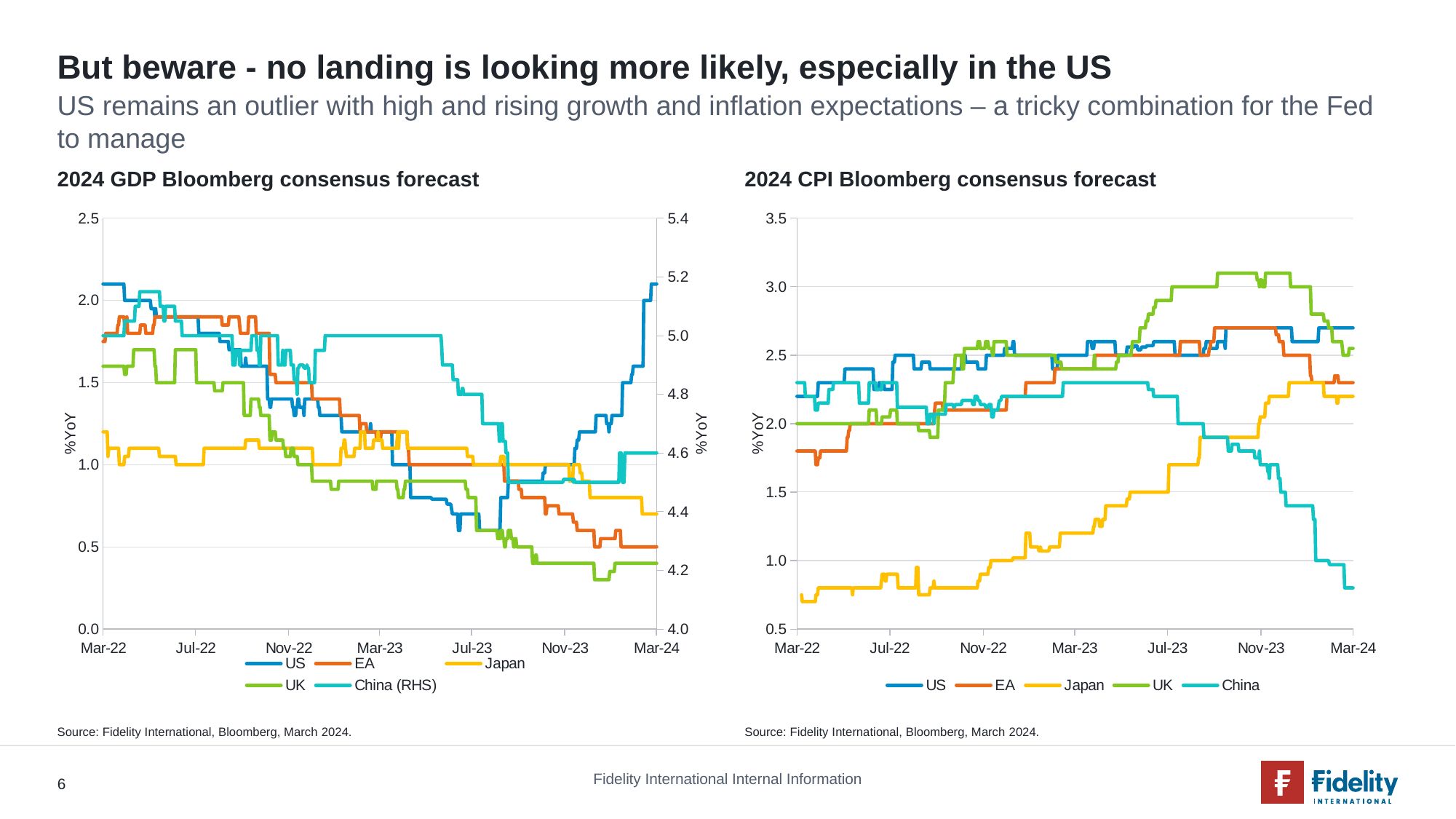
How many series does the legend of the 2024 CPI Bloomberg consensus forecast chart list? 5 In the 2024 CPI Bloomberg consensus forecast chart, is the China value at Mar-24 greater or less than 1.0? less In the 2024 CPI Bloomberg consensus forecast chart, which is larger at Mar-24, the US value or the China value? US In the 2024 CPI Bloomberg consensus forecast chart, does the Japan series rise or fall overall from Mar-22 to Mar-24? rise In the 2024 GDP Bloomberg consensus forecast chart, which series is plotted on the right-hand axis? China (RHS) In the 2024 CPI Bloomberg consensus forecast chart, which series has the lowest value at Mar-24? China In the 2024 CPI Bloomberg consensus forecast chart, which series has the highest value at Mar-24? US In the 2024 GDP Bloomberg consensus forecast chart, is the US value at Mar-24 greater or less than 2.0? greater In the 2024 GDP Bloomberg consensus forecast chart, which series has the highest value at Mar-24 on the left-hand axis? US What kind of chart is the 2024 GDP Bloomberg consensus forecast chart? line chart In the 2024 GDP Bloomberg consensus forecast chart, does the EA series rise or fall overall from Mar-22 to Mar-24? fall In the 2024 GDP Bloomberg consensus forecast chart, is the UK value at Mar-24 greater or less than 0.5? less